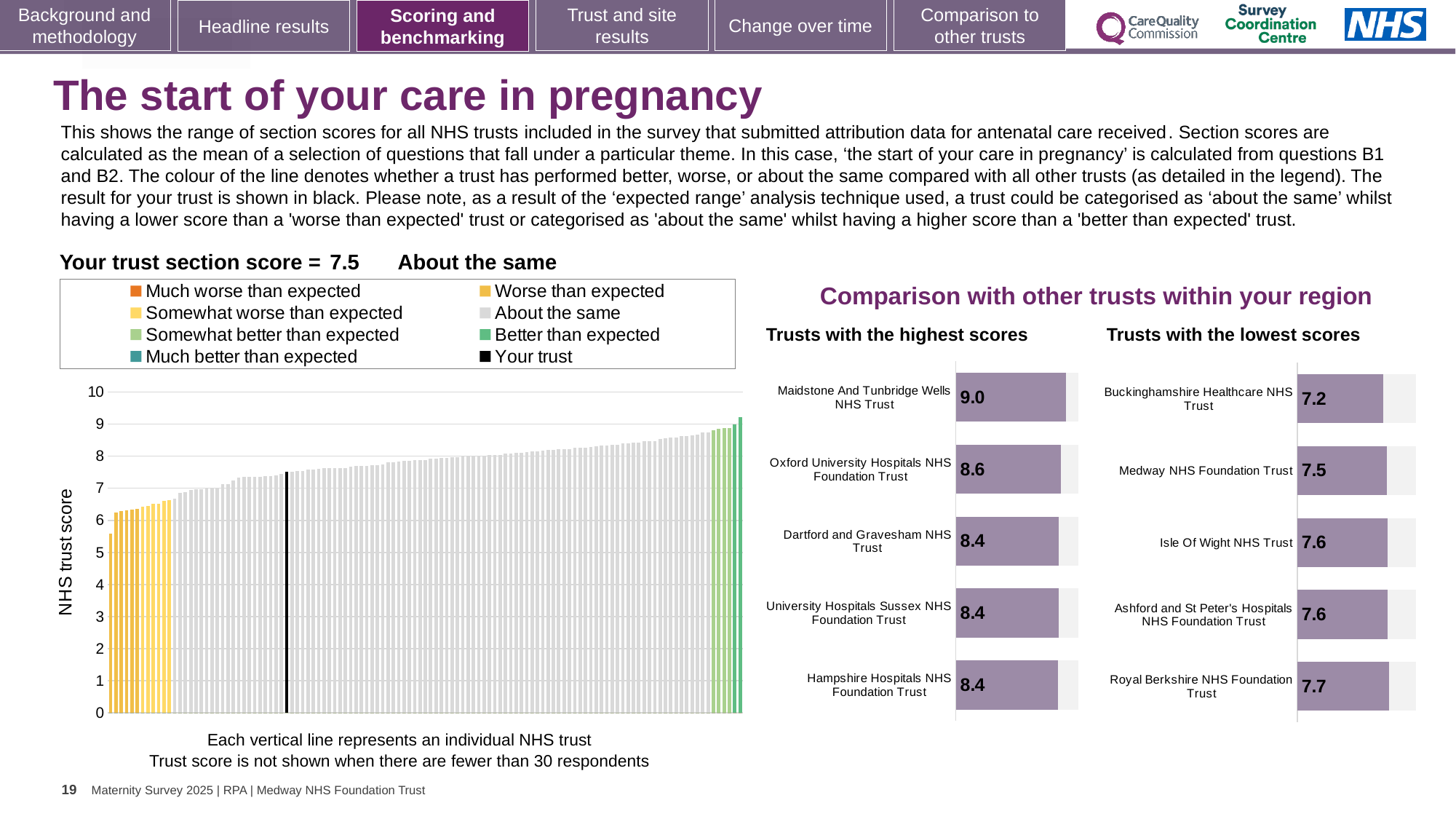
How many trusts are shown in the 'Trusts with the highest scores' chart? 5 In the 'Trusts with the lowest scores' chart, what is the score for Buckinghamshire Healthcare NHS Trust? 7.2 In the 'Trusts with the lowest scores' chart, which has the higher score: Medway NHS Foundation Trust or Royal Berkshire NHS Foundation Trust? Royal Berkshire NHS Foundation Trust In the 'Trusts with the lowest scores' chart, what is the score for Royal Berkshire NHS Foundation Trust? 7.7 In the main 'NHS trust score' chart, do the values rise or fall from left to right? Rise What kind of chart is the main 'NHS trust score' chart on the left? Bar chart In the 'Trusts with the highest scores' chart, what is the difference between the scores of Maidstone And Tunbridge Wells NHS Trust and Oxford University Hospitals NHS Foundation Trust? 0.4 In the 'Trusts with the lowest scores' chart, what is the difference between the scores of Royal Berkshire NHS Foundation Trust and Buckinghamshire Healthcare NHS Trust? 0.5 In the 'Trusts with the highest scores' chart, what is the score for Maidstone And Tunbridge Wells NHS Trust? 9.0 In the 'Trusts with the highest scores' chart, which trust has the highest score? Maidstone And Tunbridge Wells NHS Trust How many entries does the legend of the main 'NHS trust score' chart list? 8 In the 'Trusts with the lowest scores' chart, which trust has the lowest score? Buckinghamshire Healthcare NHS Trust